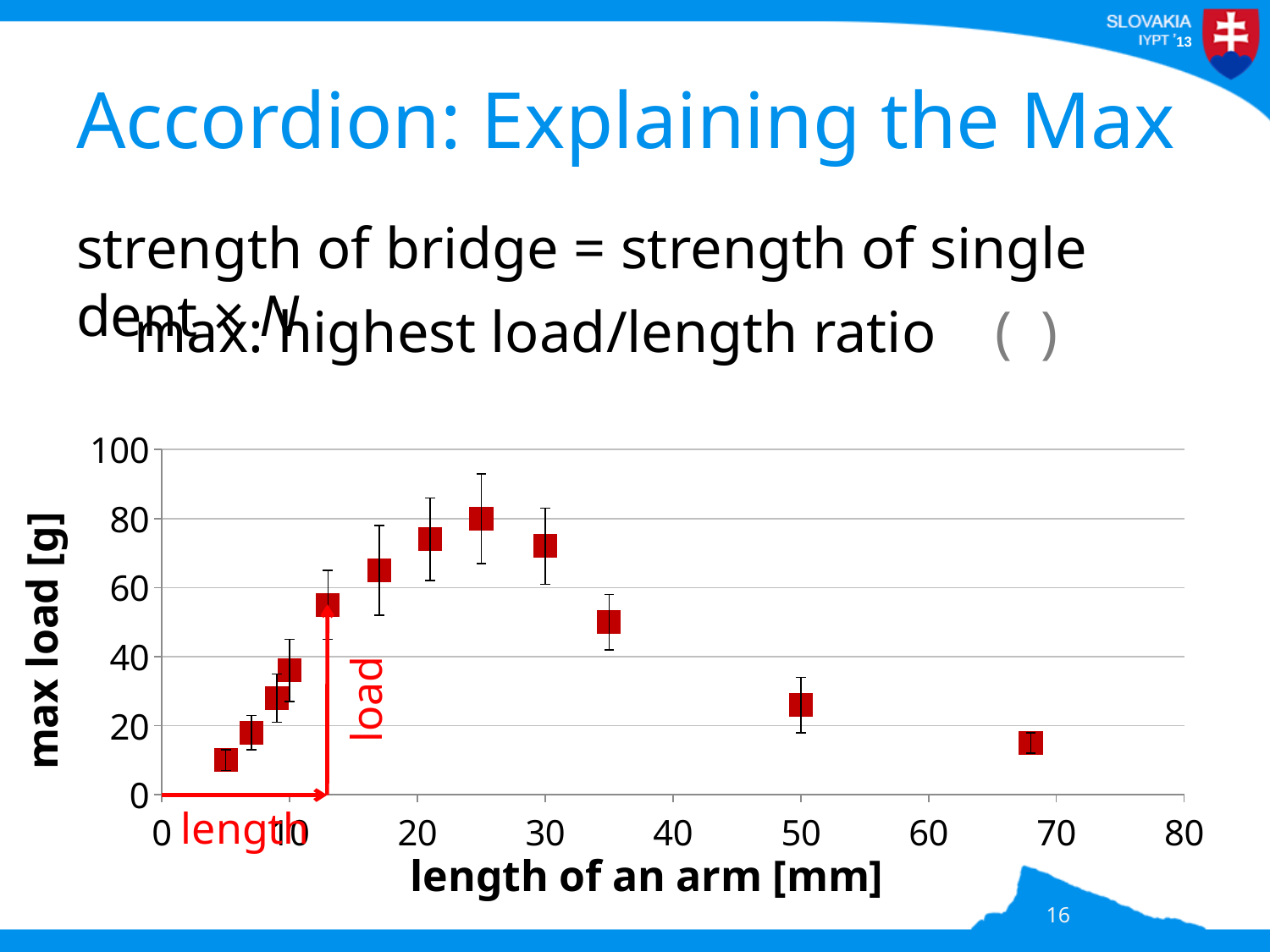
How many data points are plotted on the chart? 12 Does the highest max load occur at an arm length below or above 40 mm? below What is the title of the y axis of the chart? max load [g] Which arm length has the larger max load, 30 mm or 50 mm? 30 mm Is the max load for an arm length of 50 mm greater or less than 20? greater Is the highest max load on the chart greater or less than 60? greater Is the max load for an arm length of 50 mm greater or less than 40? less What is the title of the x axis of the chart? length of an arm [mm] What kind of chart is shown on the slide? scatter plot How does the max load change as the arm length increases from 0 to 80 mm? rises then falls